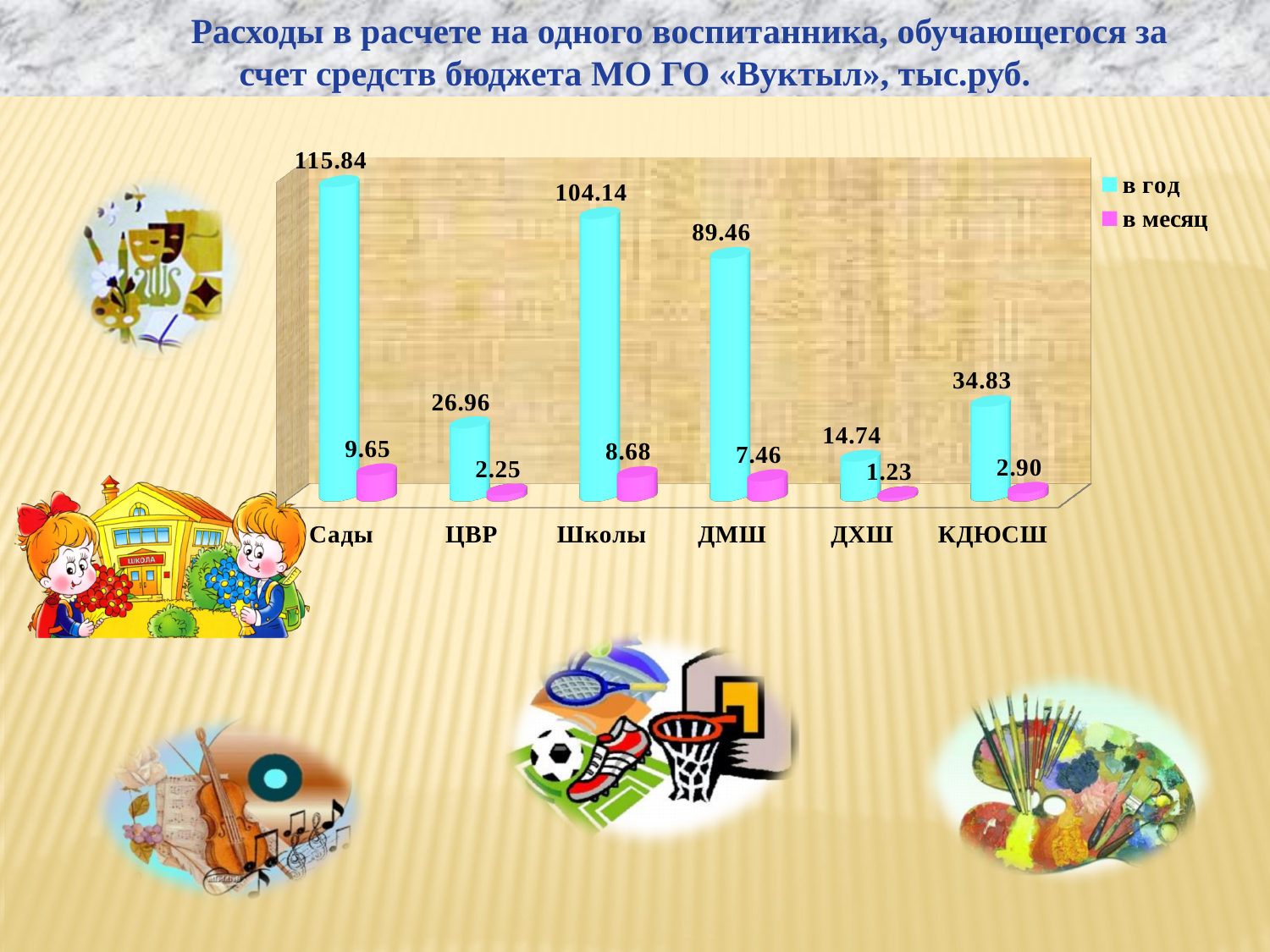
Which series is shown in pink in the legend? в месяц Which category has the highest 'в год' value? Сады Which is larger: the 'в год' value for ЦВР or for КДЮСШ? КДЮСШ What is the difference between the 'в год' values for Сады and Школы? 11.70 What is the difference between the 'в месяц' values for Школы and ЦВР? 6.43 How many series does the legend list? 2 How many categories are shown on the x axis? 6 Which category has the lowest 'в месяц' value? ДХШ What is the value of 'в год' for КДЮСШ? 34.83 What is the value of 'в месяц' for ДМШ? 7.46 What kind of chart is shown on the slide? Bar chart What is the value of 'в год' for Сады? 115.84